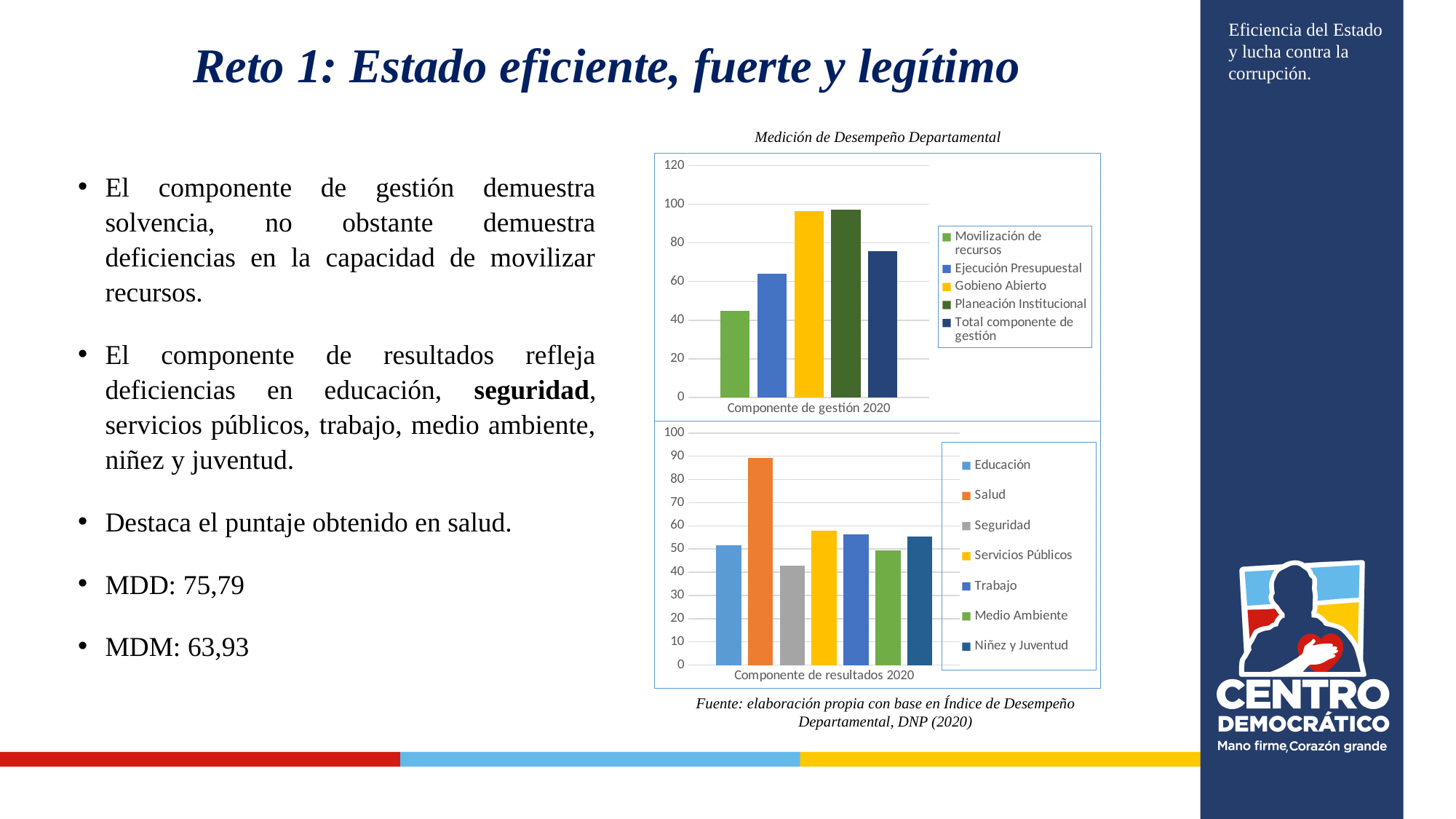
In the bottom chart 'Componente de resultados 2020', which series has the lowest value? Seguridad In the top chart 'Componente de gestión 2020', which series has the lowest value? Movilización de recursos In the bottom chart 'Componente de resultados 2020', is the value for Seguridad greater or less than 50? less In the bottom chart 'Componente de resultados 2020', which series has the highest value? Salud In the bottom chart 'Componente de resultados 2020', how many series does the legend list? 7 What kind of chart is the top chart, 'Componente de gestión 2020'? bar chart In the top chart 'Componente de gestión 2020', how many series does the legend list? 5 In the top chart 'Componente de gestión 2020', is the value for Movilización de recursos greater or less than 60? less In the top chart 'Componente de gestión 2020', is the value for Gobierno Abierto greater or less than 80? greater What is the title shown above the two charts? Medición de Desempeño Departamental In the top chart 'Componente de gestión 2020', which is larger: Ejecución Presupuestal or Total componente de gestión? Total componente de gestión